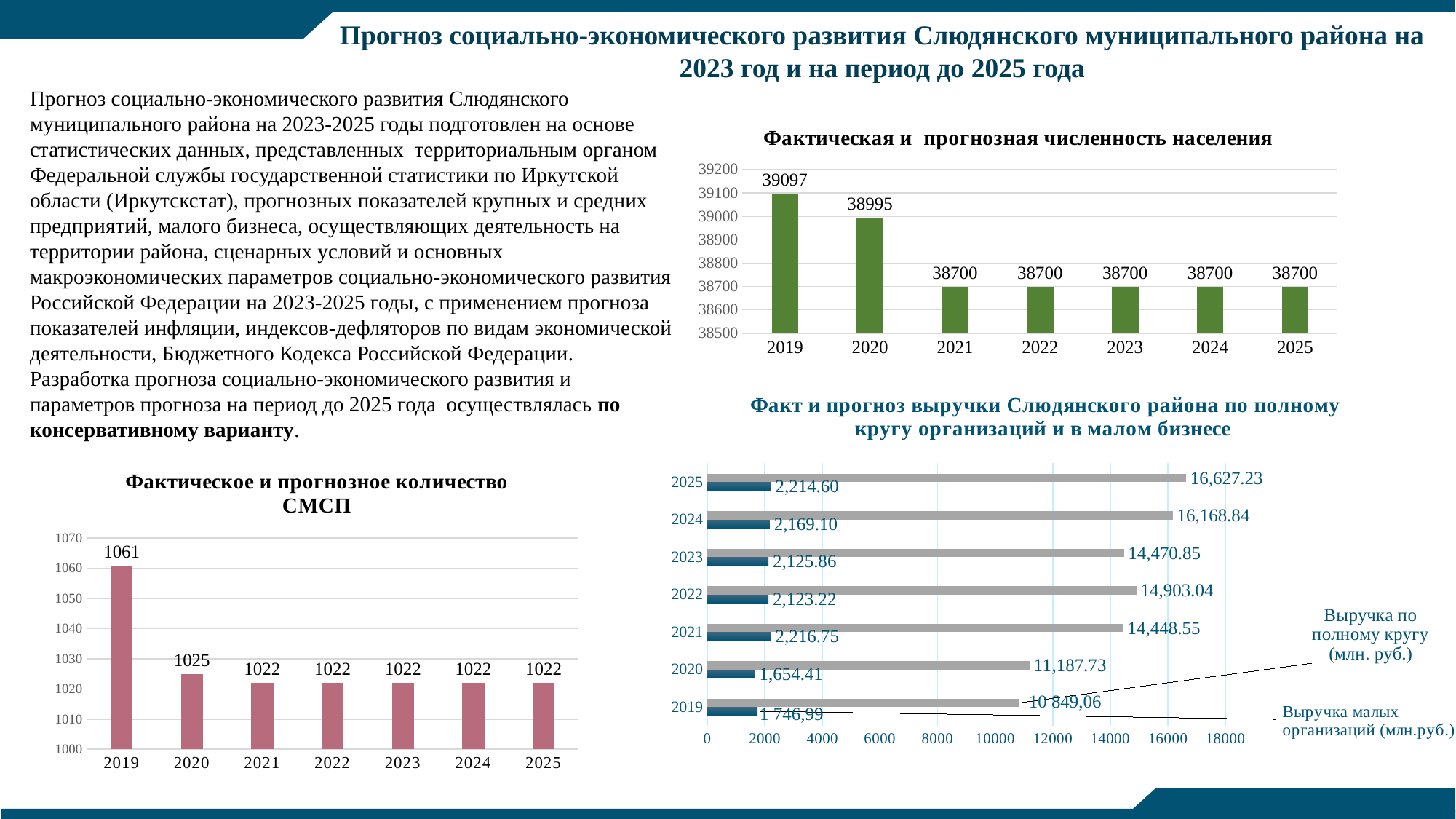
In the chart 'Факт и прогноз выручки Слюдянского района по полному кругу организаций и в малом бизнесе', what is the value of 'Выручка малых организаций (млн.руб.)' for 2020? 1,654.41 In the chart 'Фактическое и прогнозное количество СМСП', which year has the highest value? 2019 In the chart 'Фактическое и прогнозное количество СМСП', what is the value for 2020? 1025 In the chart 'Факт и прогноз выручки Слюдянского района по полному кругу организаций и в малом бизнесе', what is the value of 'Выручка по полному кругу (млн. руб.)' for 2025? 16,627.23 In the chart 'Фактическая и прогнозная численность населения', which year has the lowest value? 2021, 2022, 2023, 2024 and 2025 (all 38700) In the chart 'Фактическая и прогнозная численность населения', do the values rise or fall from 2019 to 2021? fall In the chart 'Фактическое и прогнозное количество СМСП', how many years are shown on the x axis? 7 What kind of chart is 'Факт и прогноз выручки Слюдянского района по полному кругу организаций и в малом бизнесе'? bar chart In the chart 'Фактическая и прогнозная численность населения', what is the value for 2019? 39097 In the chart 'Фактическое и прогнозное количество СМСП', what is the difference between the 2019 and 2025 values? 39 In the chart 'Факт и прогноз выручки Слюдянского района по полному кругу организаций и в малом бизнесе', which is larger for 'Выручка по полному кругу (млн. руб.)': 2022 or 2023? 2022 In the chart 'Фактическая и прогнозная численность населения', what is the difference between the 2019 and 2020 values? 102